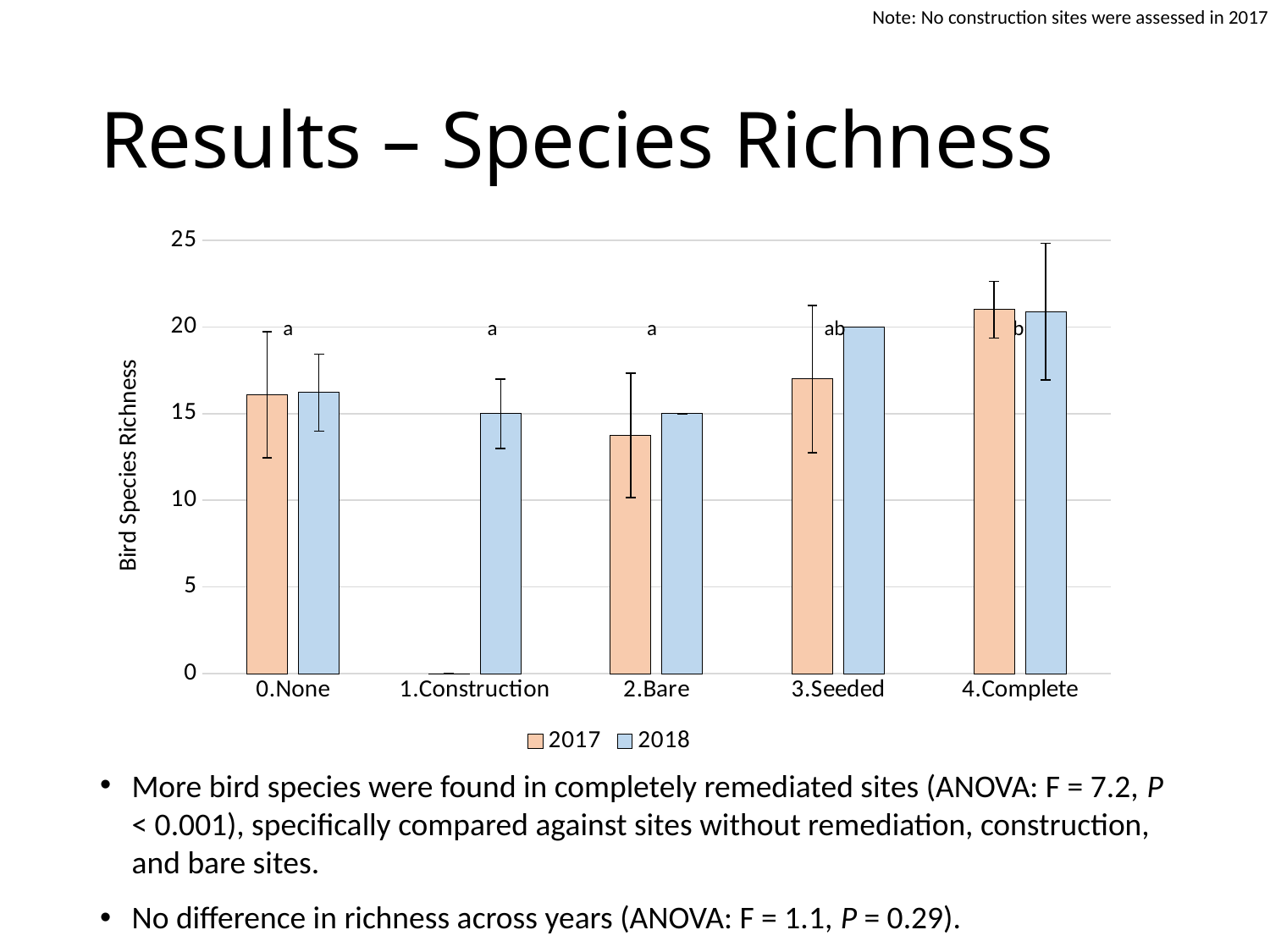
How many categories are shown on the x axis? 5 How many series does the legend list? 2 What kind of chart is shown on the slide? bar chart Is the 2017 value for 0.None greater or less than 15? greater Is the 2017 value for 3.Seeded greater or less than 20? less Is the 2018 value for 4.Complete greater or less than 20? greater For 2.Bare, which year has the larger bar, 2017 or 2018? 2018 What is the title of the y axis? Bird Species Richness Which category has the highest 2017 bar? 4.Complete What is the 2018 value for 3.Seeded? 20 For 3.Seeded, which year has the larger bar, 2017 or 2018? 2018